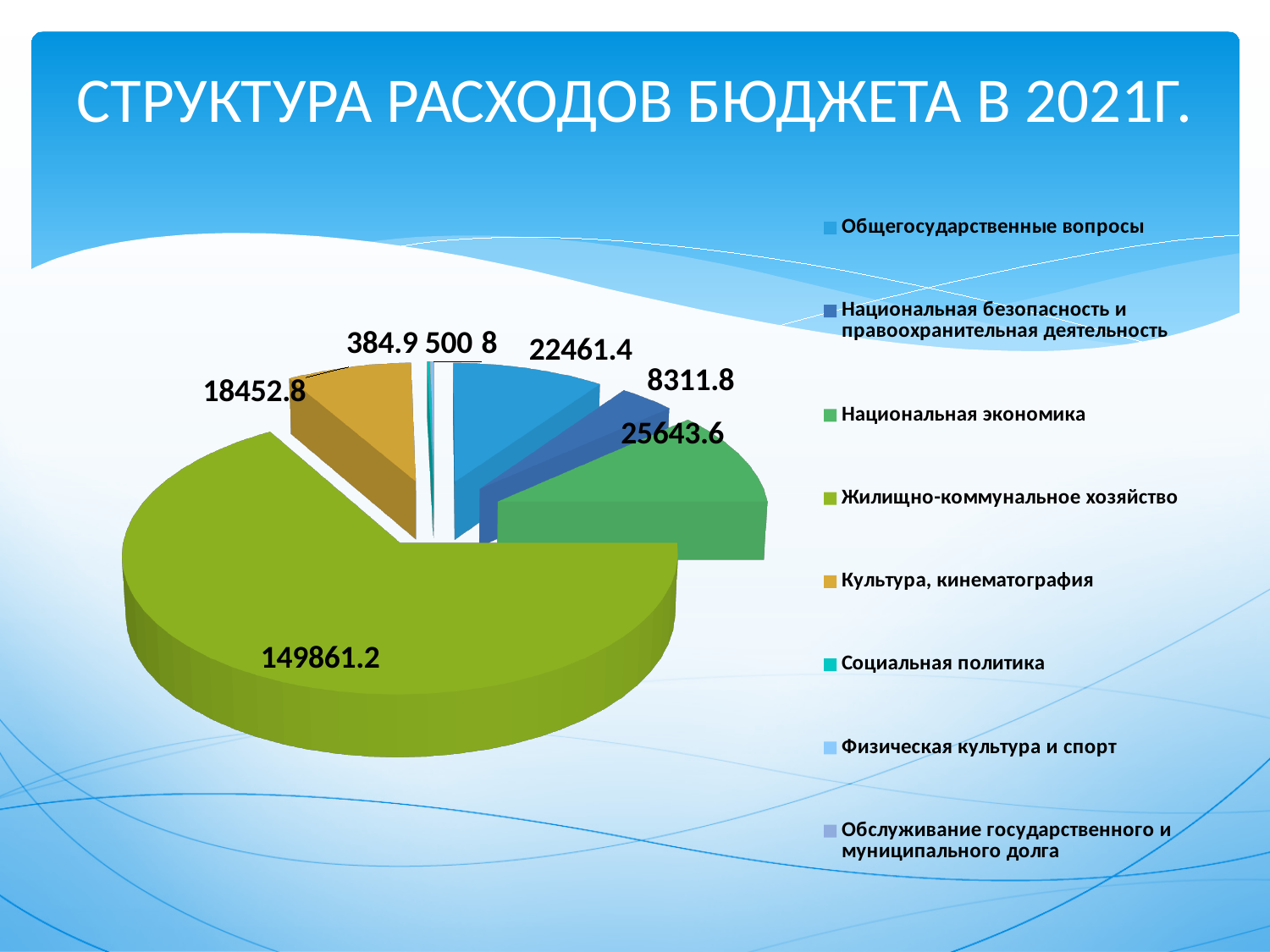
Which is larger: the value for Общегосударственные вопросы or the value for Культура, кинематография? Общегосударственные вопросы Which category has the smallest value? Обслуживание государственного и муниципального долга What is the value for Национальная безопасность и правоохранительная деятельность? 8311.8 What is the value for Национальная экономика? 25643.6 What is the value for Общегосударственные вопросы? 22461.4 What is the title of the slide? СТРУКТУРА РАСХОДОВ БЮДЖЕТА В 2021Г. Which category has the largest slice of the pie? Жилищно-коммунальное хозяйство What is the value for Жилищно-коммунальное хозяйство? 149861.2 What is the value for Культура, кинематография? 18452.8 How many categories does the pie chart have? 8 What is the difference between the values for Национальная экономика and Общегосударственные вопросы? 3182.2 What kind of chart is shown on the slide? pie chart